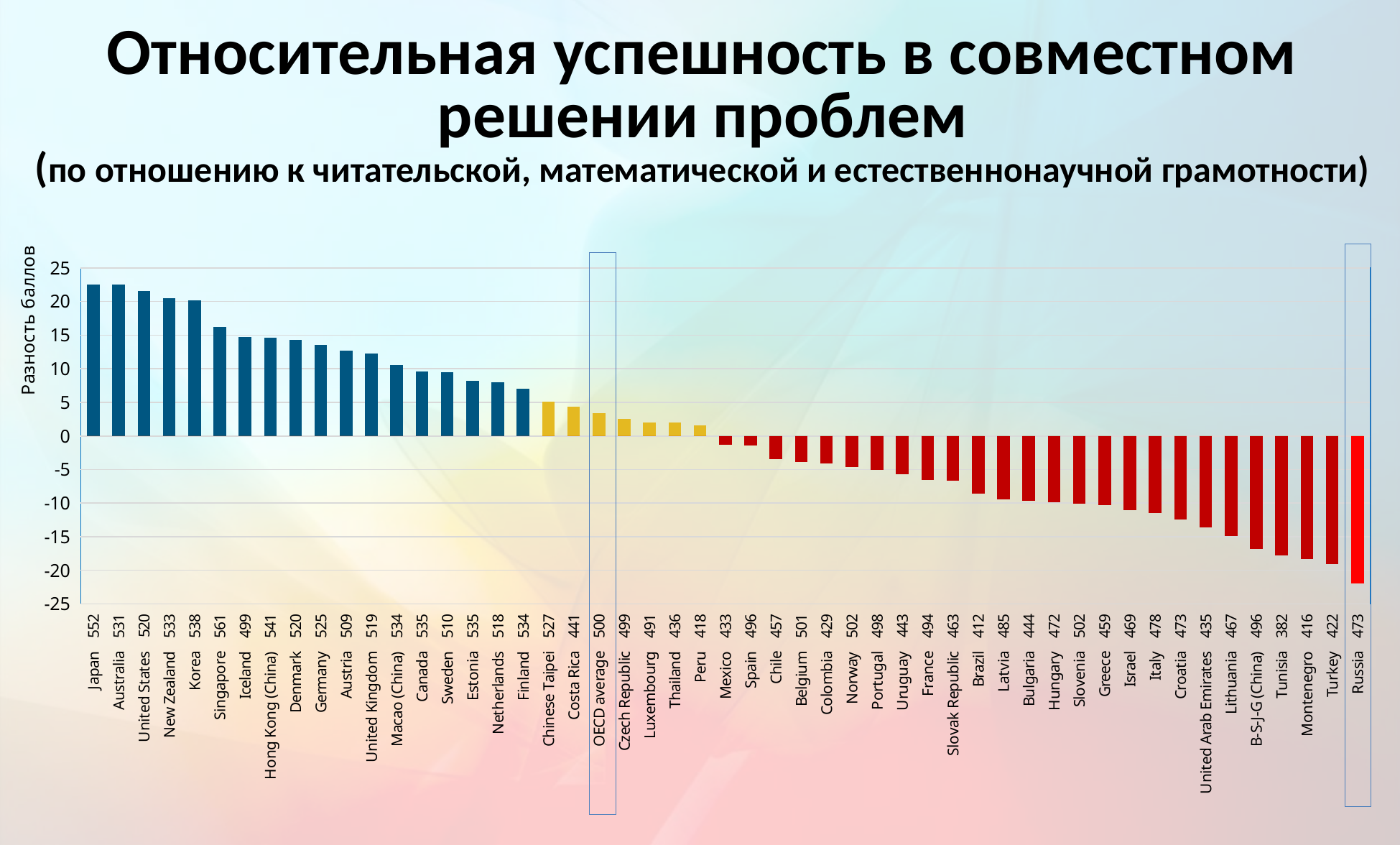
Is the value for Japan greater or less than 20? greater Which has the larger value, Turkey or Russia? Turkey How many categories are plotted on the chart? 51 Which category has the lowest value on the chart? Russia Do the values rise or fall moving from left to right along the x axis? fall Which has the larger value, Singapore or Finland? Singapore Is the value for Russia greater or less than -20? less What is the title of the vertical axis? Разность баллов Is the value for Turkey greater or less than -15? less What kind of chart is shown on the slide? bar chart